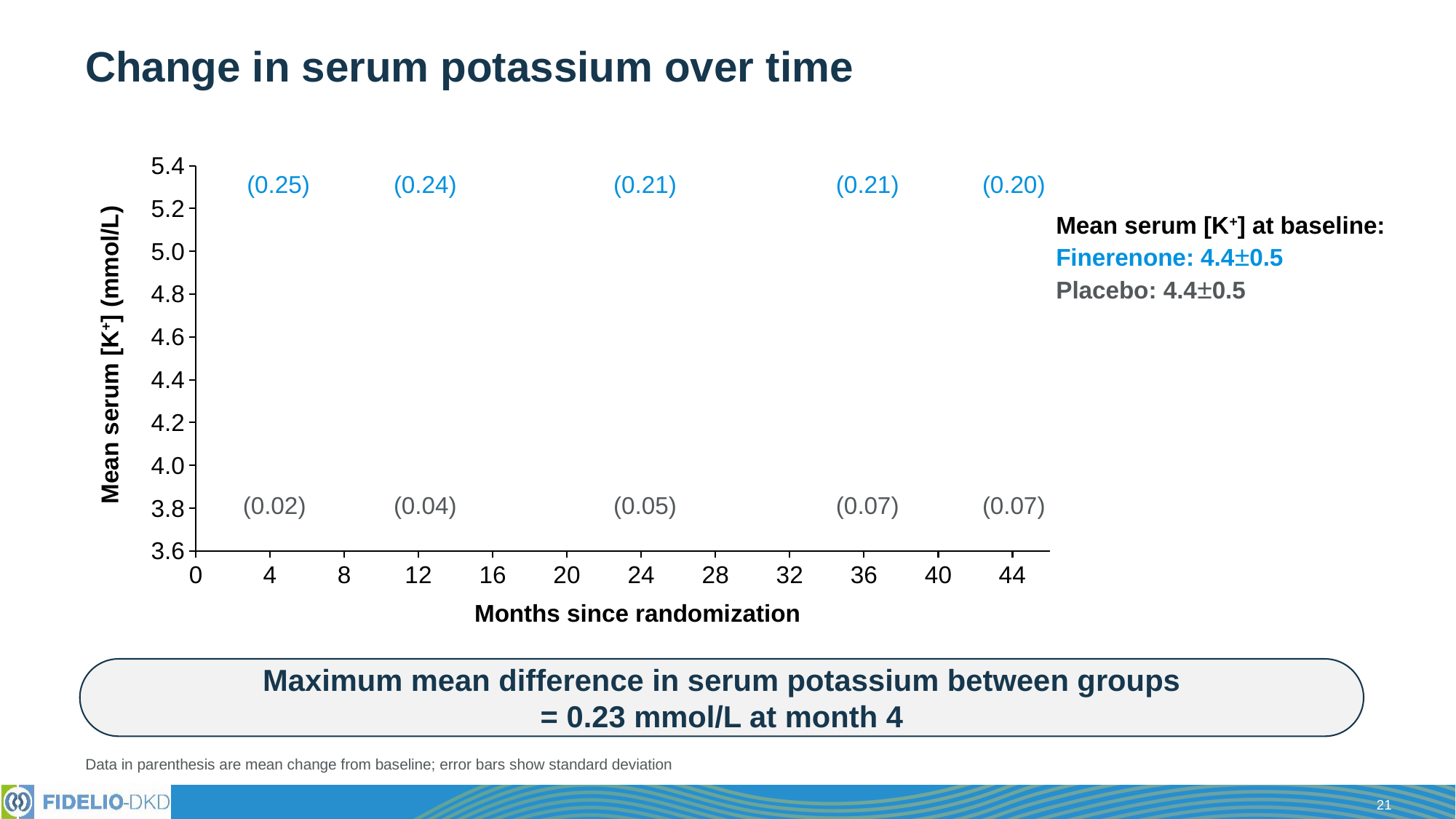
What is the mean change from baseline in serum potassium for placebo at month 44? 0.07 What is the mean change from baseline for finerenone at month 24? 0.21 Does the placebo mean change from baseline rise or fall from month 4 to month 44? Rise Does the finerenone mean change from baseline rise or fall from month 4 to month 44? Fall At which month is the placebo mean change from baseline the smallest? Month 4 At which month is the finerenone mean change from baseline the largest? Month 4 At month 36, which group has the larger mean change from baseline: finerenone or placebo? Finerenone How many time points have mean change from baseline values labelled on the chart? 5 What is the difference between the finerenone and placebo mean change from baseline at month 4? 0.23 What is the mean serum potassium at baseline for the finerenone group? 4.4±0.5 What is the label of the x axis? Months since randomization What is the mean change from baseline in serum potassium for finerenone at month 4? 0.25